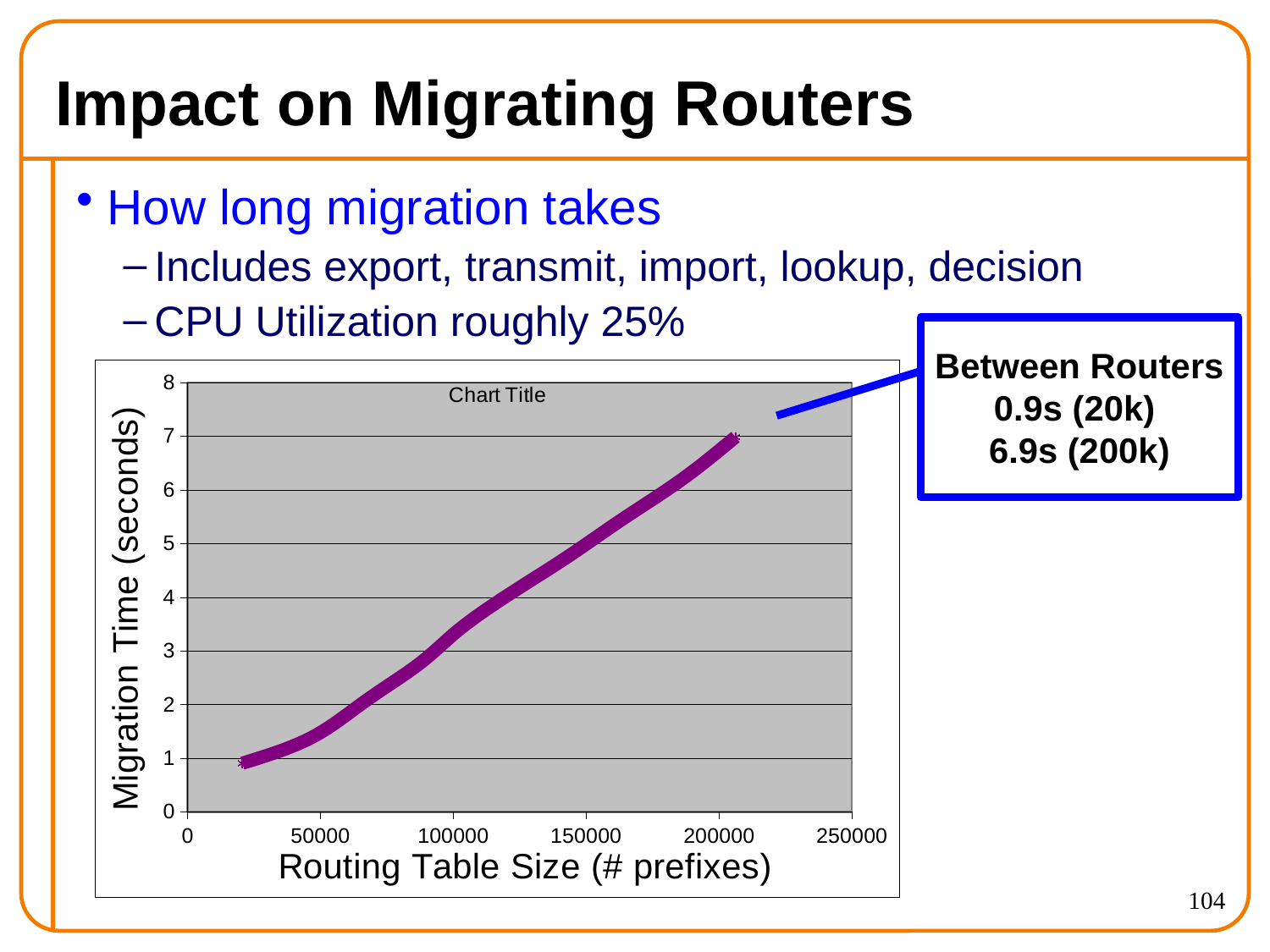
What kind of chart is shown on the slide? line chart Which routing table size has the larger migration time, 20k or 200k? 200k What is the migration time for a routing table size of 20k prefixes? 0.9s Is the migration time at a routing table size of 100000 greater or less than 4 seconds? less Is the migration time at a routing table size of 50000 greater or less than 2 seconds? less What is the label of the x axis of the chart? Routing Table Size (# prefixes) What is the migration time for a routing table size of 200k prefixes? 6.9s Is the migration time at a routing table size of 150000 greater or less than 4 seconds? greater What is the label of the y axis of the chart? Migration Time (seconds) What is the difference in migration time between the 200k and 20k routing table sizes? 6.0s Does migration time rise or fall as routing table size increases along the x axis? rise